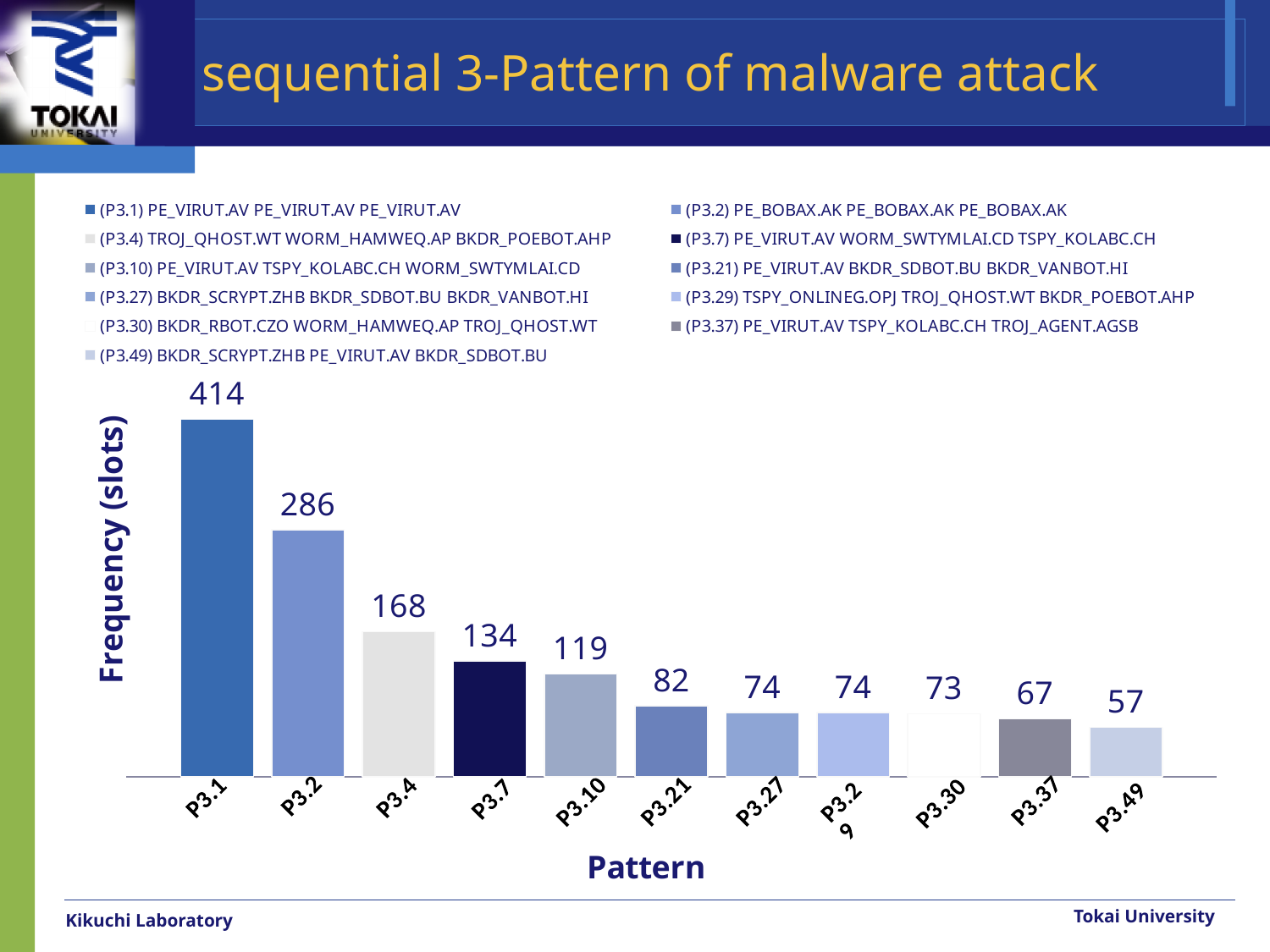
What kind of chart is shown on the slide? Bar chart What is the difference in frequency between P3.4 and P3.10? 49 What is the difference in frequency between P3.1 and P3.2? 128 Which has a higher frequency, P3.21 or P3.37? P3.21 How many patterns are plotted on the x axis? 11 What is the frequency value for pattern P3.1? 414 Do the frequency values rise or fall from left to right along the x axis? Fall Which pattern has the lowest frequency? P3.49 How many entries does the legend list? 11 What is the frequency value for pattern P3.7? 134 Which pattern has the highest frequency? P3.1 What is the frequency value for pattern P3.30? 73